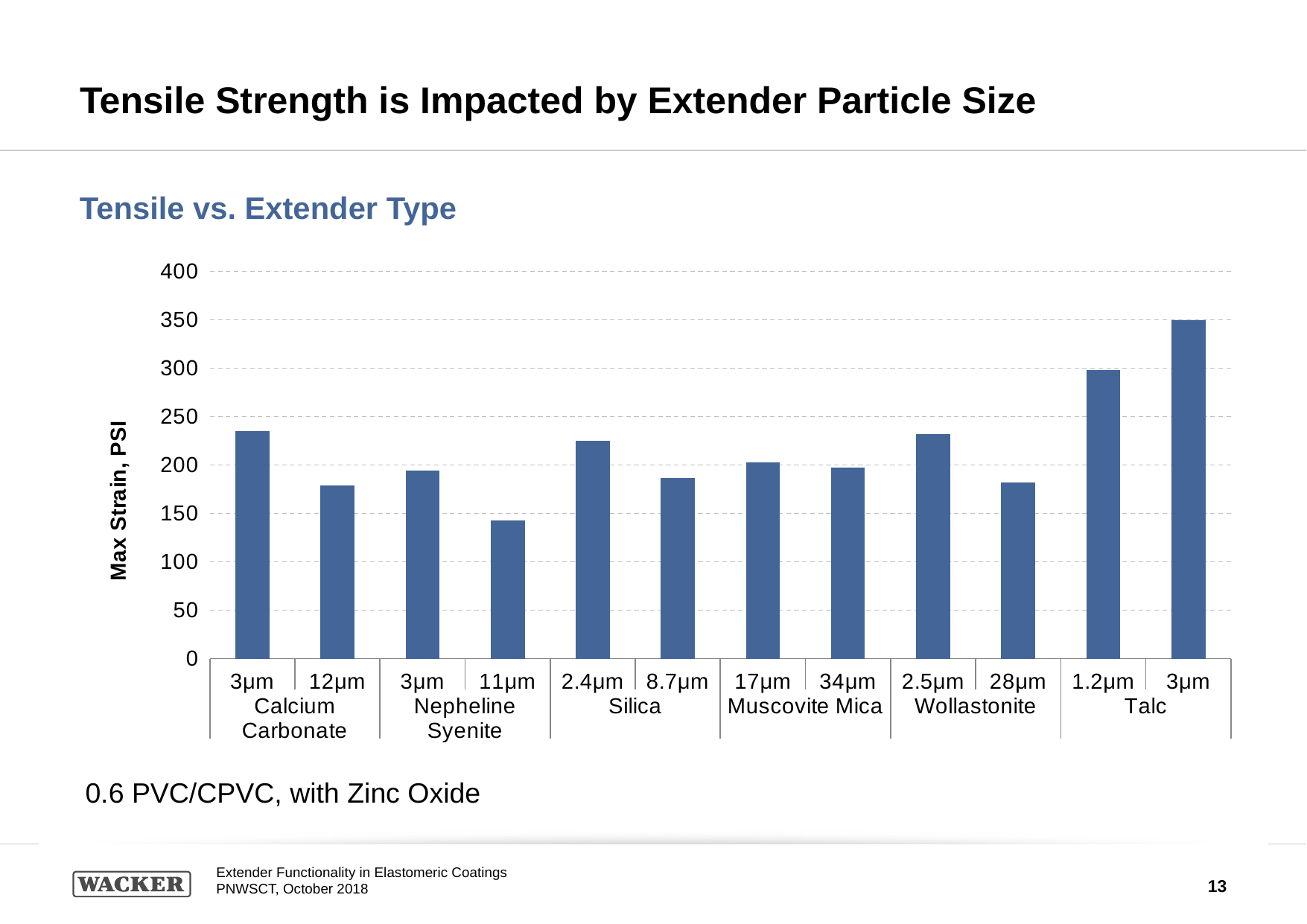
Which bar has the highest value in the chart? Talc, 3µm What kind of chart is shown on the slide? Bar chart Within each extender type, does the bar for the larger particle size rise or fall compared to the smaller particle size? It falls for every extender type except Talc, where the 3µm bar rises above the 1.2µm bar Is the value for Wollastonite 28µm greater or less than 200? less Which bar has the lowest value in the chart? Nepheline Syenite, 11µm Which is larger, the value for Silica 2.4µm or Silica 8.7µm? Silica 2.4µm What is the label on the y axis of the chart? Max Strain, PSI How many extender types are shown along the x axis? 6 How many bars are plotted in the chart? 12 Is the value for Calcium Carbonate 3µm greater or less than 200? greater Is the value for Talc 3µm greater or less than 300? greater